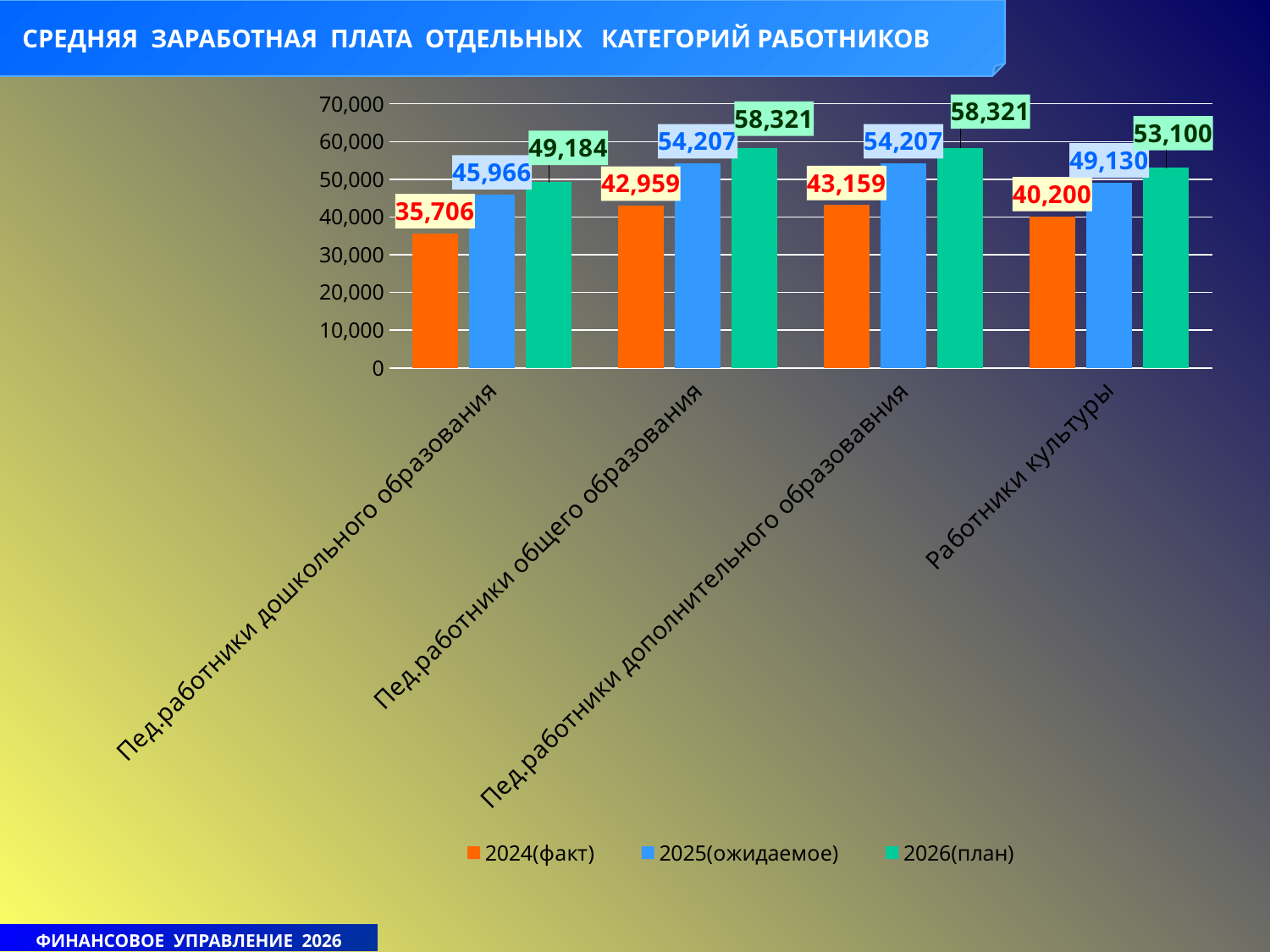
What is the 2026(план) value for Работники культуры? 53,100 Which colour represents the 2026(план) series in the legend? green Which category has the lowest 2024(факт) value? Пед.работники дошкольного образования What kind of chart is shown on the slide? bar chart How many series does the legend list? 3 For Пед.работники дошкольного образования, do the values rise or fall from 2024(факт) to 2026(план)? rise What is the difference between the 2026(план) and 2024(факт) values for Работники культуры? 12,900 How many categories of workers are shown on the x axis? 4 Which category has the highest 2025(ожидаемое) value? Пед.работники общего образования and Пед.работники дополнительного образовавния (both 54,207) What is the 2025(ожидаемое) value for Пед.работники общего образования? 54,207 What is the 2024(факт) value for Пед.работники дошкольного образования? 35,706 Which is larger: the 2024(факт) value for Пед.работники общего образования or for Пед.работники дополнительного образовавния? Пед.работники дополнительного образовавния